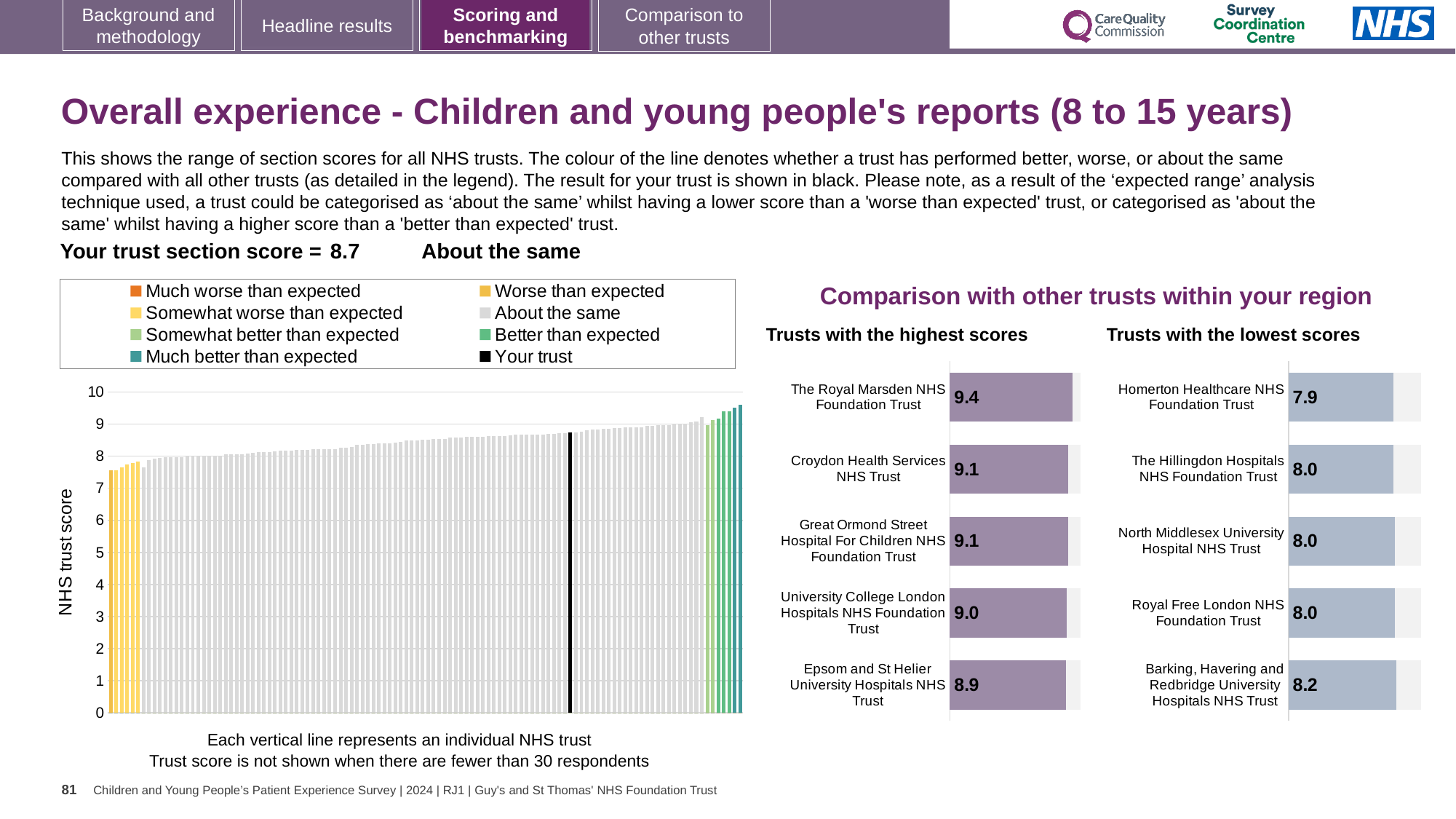
In the 'Trusts with the lowest scores' chart, which trust has the highest score? Barking, Havering and Redbridge University Hospitals NHS Trust In the 'Trusts with the highest scores' chart, what is the difference between The Royal Marsden NHS Foundation Trust's score and Epsom and St Helier University Hospitals NHS Trust's score? 0.5 What is the y-axis label of the large chart on the left? NHS trust score In the 'Trusts with the lowest scores' chart, what is the score for Homerton Healthcare NHS Foundation Trust? 7.9 What kind of chart is the large chart on the left showing NHS trust scores? Bar chart Which score is larger: The Royal Marsden NHS Foundation Trust in the highest scores chart or Homerton Healthcare NHS Foundation Trust in the lowest scores chart? The Royal Marsden NHS Foundation Trust In the 'Trusts with the lowest scores' chart, what is the difference between the scores of Barking, Havering and Redbridge University Hospitals NHS Trust and Homerton Healthcare NHS Foundation Trust? 0.3 How many entries does the legend of the large chart on the left list? 8 In the 'Trusts with the highest scores' chart, how many trusts are listed? 5 In the large chart on the left, is the value for the black bar (Your trust) greater or less than 8? greater In the 'Trusts with the highest scores' chart, which trust has the lowest score? Epsom and St Helier University Hospitals NHS Trust In the 'Trusts with the highest scores' chart, what is the score for The Royal Marsden NHS Foundation Trust? 9.4